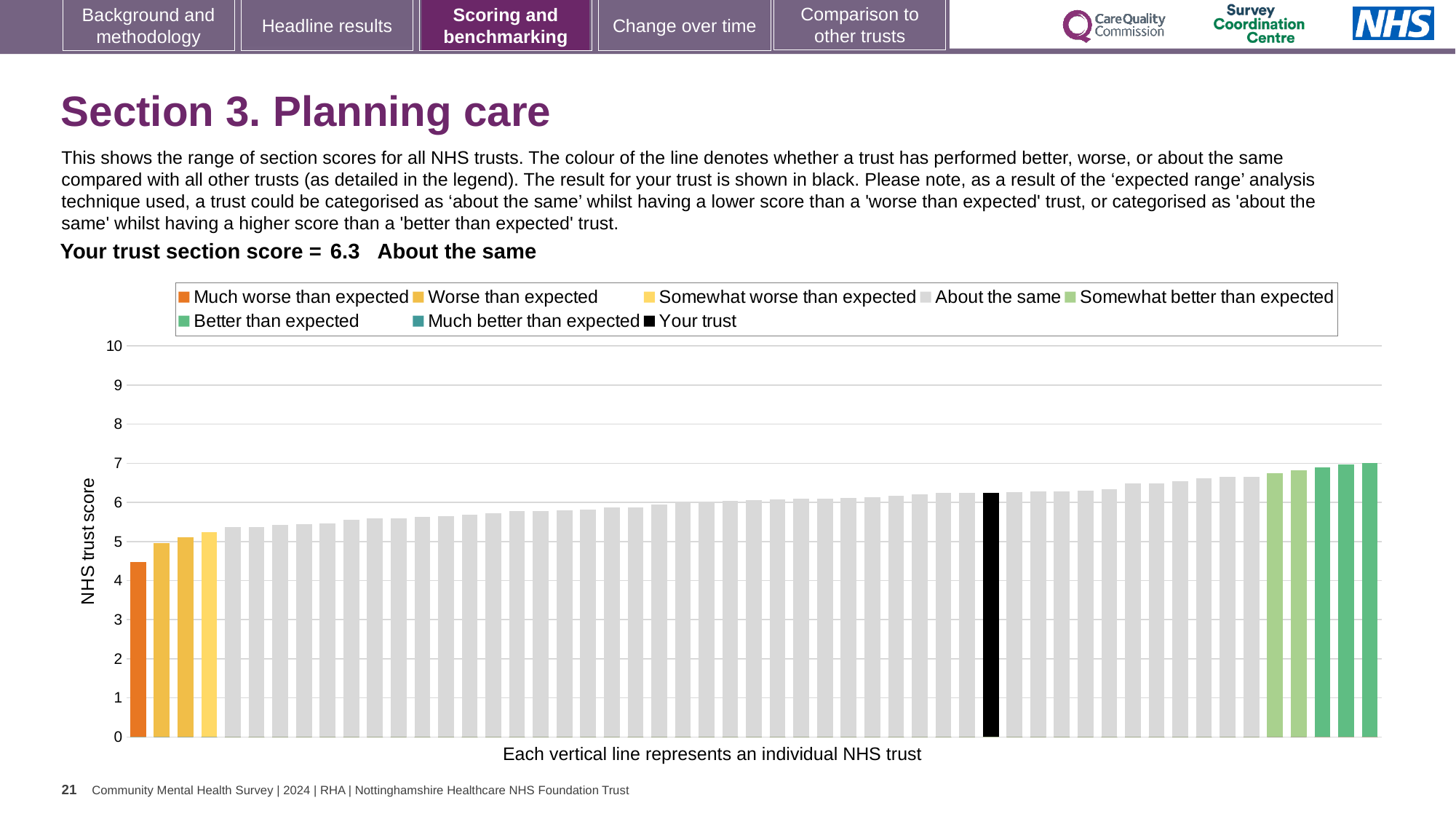
Is the value of the lowest bar (the orange 'Much worse than expected' trust) greater or less than 5? less What kind of chart is shown on the slide? bar chart What colour is the bar representing your trust? black Do the bar values rise or fall from left to right along the x axis? rise Is the value for your trust greater or less than 5? greater How many entries does the chart legend list? 8 What is the label on the vertical axis of the chart? NHS trust score How many bars are coloured as 'Much worse than expected'? 1 Is the value of the highest bar greater or less than 6? greater What is the section score for your trust? 6.3 Which legend category does the highest bar belong to? Better than expected Which legend category does the lowest bar belong to? Much worse than expected